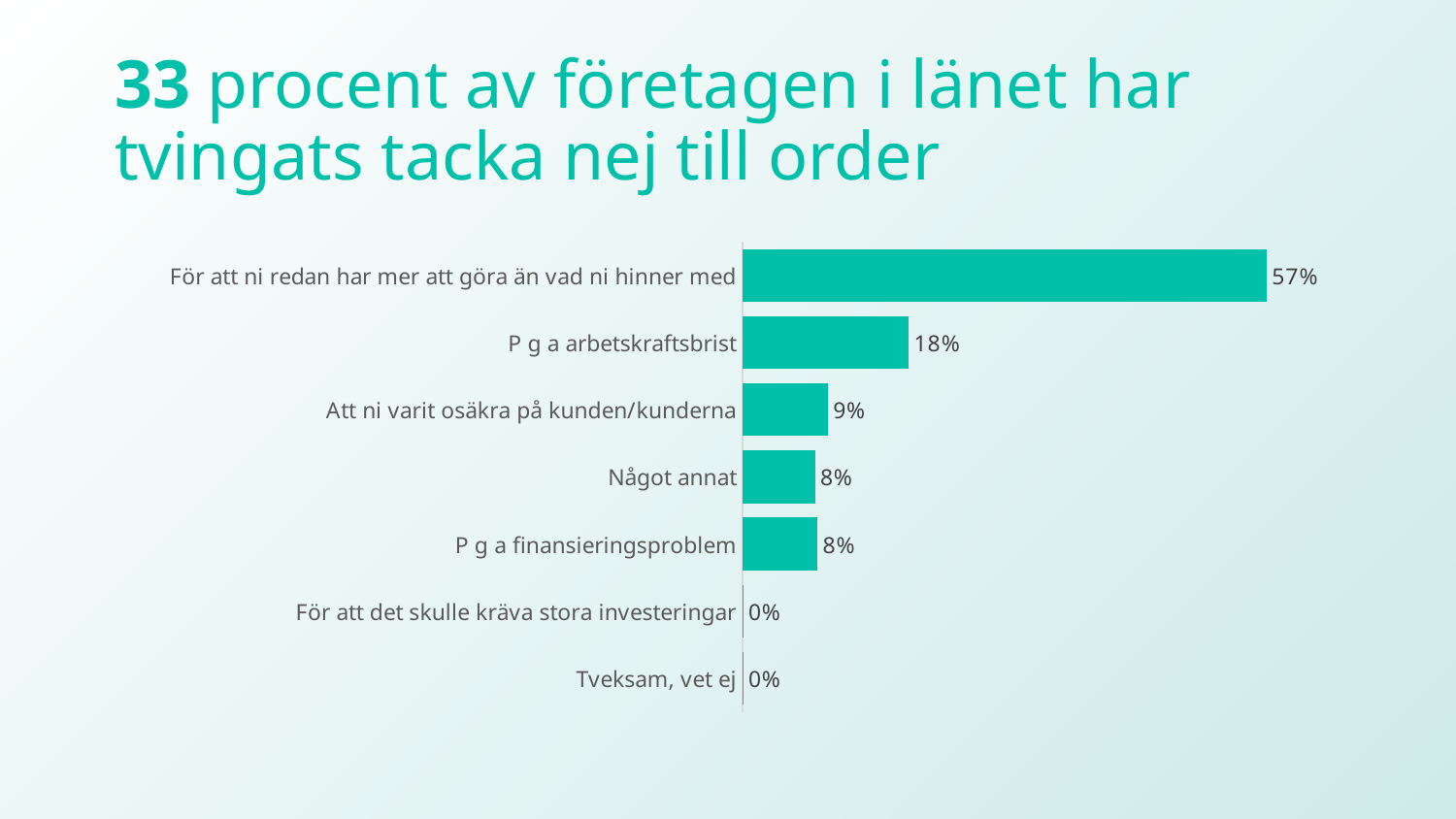
What is the difference between the values for "För att ni redan har mer att göra än vad ni hinner med" and "P g a arbetskraftsbrist"? 39% What kind of chart is shown on the slide? Bar chart Which category has the highest value? För att ni redan har mer att göra än vad ni hinner med How many categories are shown in the chart? 7 What is the value for "P g a arbetskraftsbrist"? 18% What is the value for "För att det skulle kräva stora investeringar"? 0% What is the value for "Att ni varit osäkra på kunden/kunderna"? 9% What is the value for "Något annat"? 8% Which is larger, the value for "P g a arbetskraftsbrist" or the value for "Något annat"? P g a arbetskraftsbrist What colour are the bars in the chart? Teal How many categories have a value of 0%? 2 What is the difference between the values for "Att ni varit osäkra på kunden/kunderna" and "P g a finansieringsproblem"? 1%